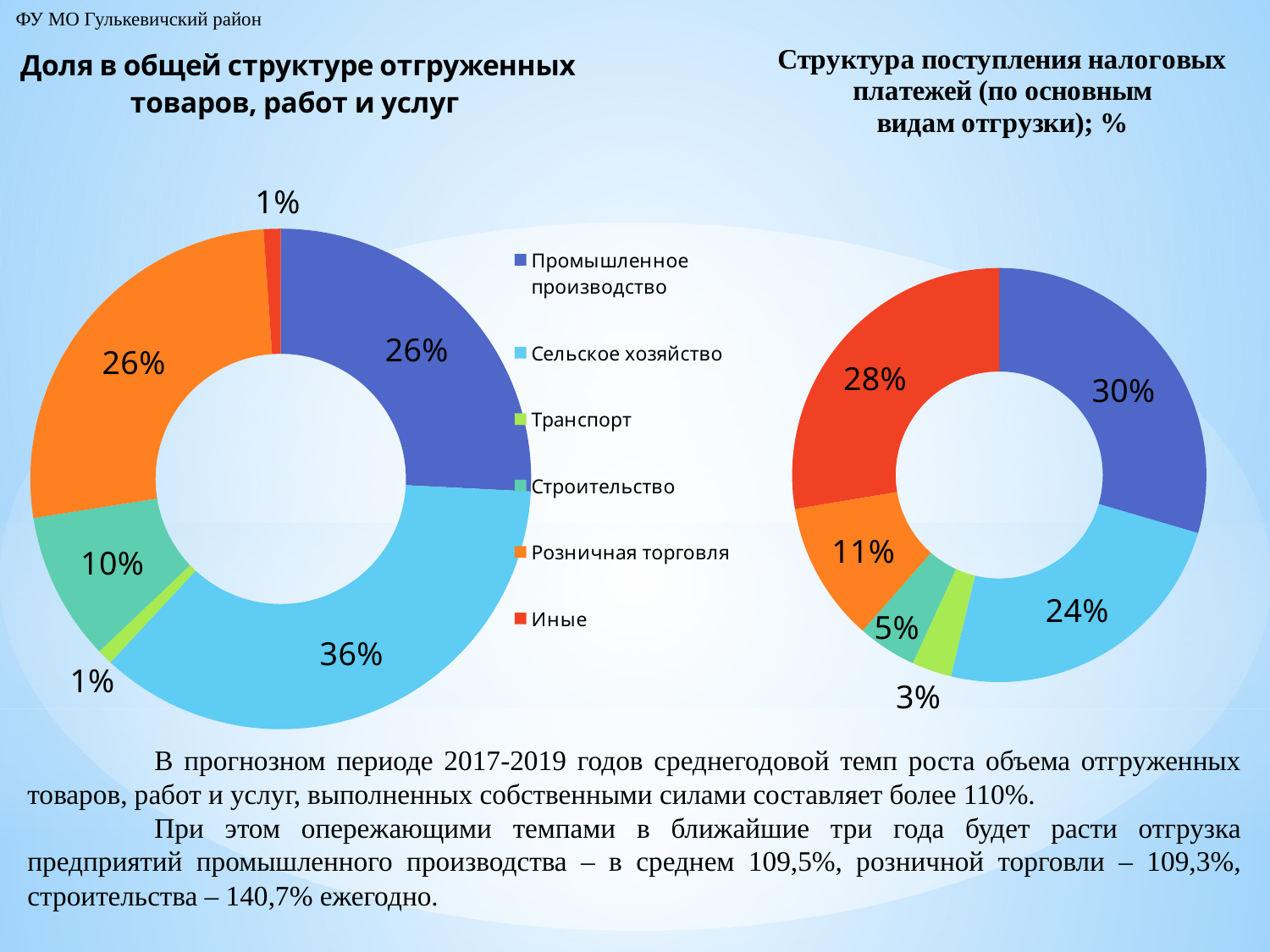
How many categories does the legend list for the charts on the slide? 6 In the left chart 'Доля в общей структуре отгруженных товаров, работ и услуг', what share does Сельское хозяйство have? 36% In the right chart 'Структура поступления налоговых платежей', which category has the smallest share? Транспорт In the left chart 'Доля в общей структуре отгруженных товаров, работ и услуг', which category has the largest share? Сельское хозяйство In the left chart 'Доля в общей структуре отгруженных товаров, работ и услуг', what share does Иные have? 1% In the left chart 'Доля в общей структуре отгруженных товаров, работ и услуг', what share does Строительство have? 10% What kind of chart is the left chart 'Доля в общей структуре отгруженных товаров, работ и услуг'? Doughnut chart In the right chart 'Структура поступления налоговых платежей', which is larger: the share of Иные or the share of Сельское хозяйство? Иные In the right chart 'Структура поступления налоговых платежей', what is the difference between the shares of Промышленное производство and Сельское хозяйство? 6% In the right chart 'Структура поступления налоговых платежей', what share does Розничная торговля have? 11% In the right chart 'Структура поступления налоговых платежей', what share does Промышленное производство have? 30% Which colour represents Розничная торговля in the legend? Orange